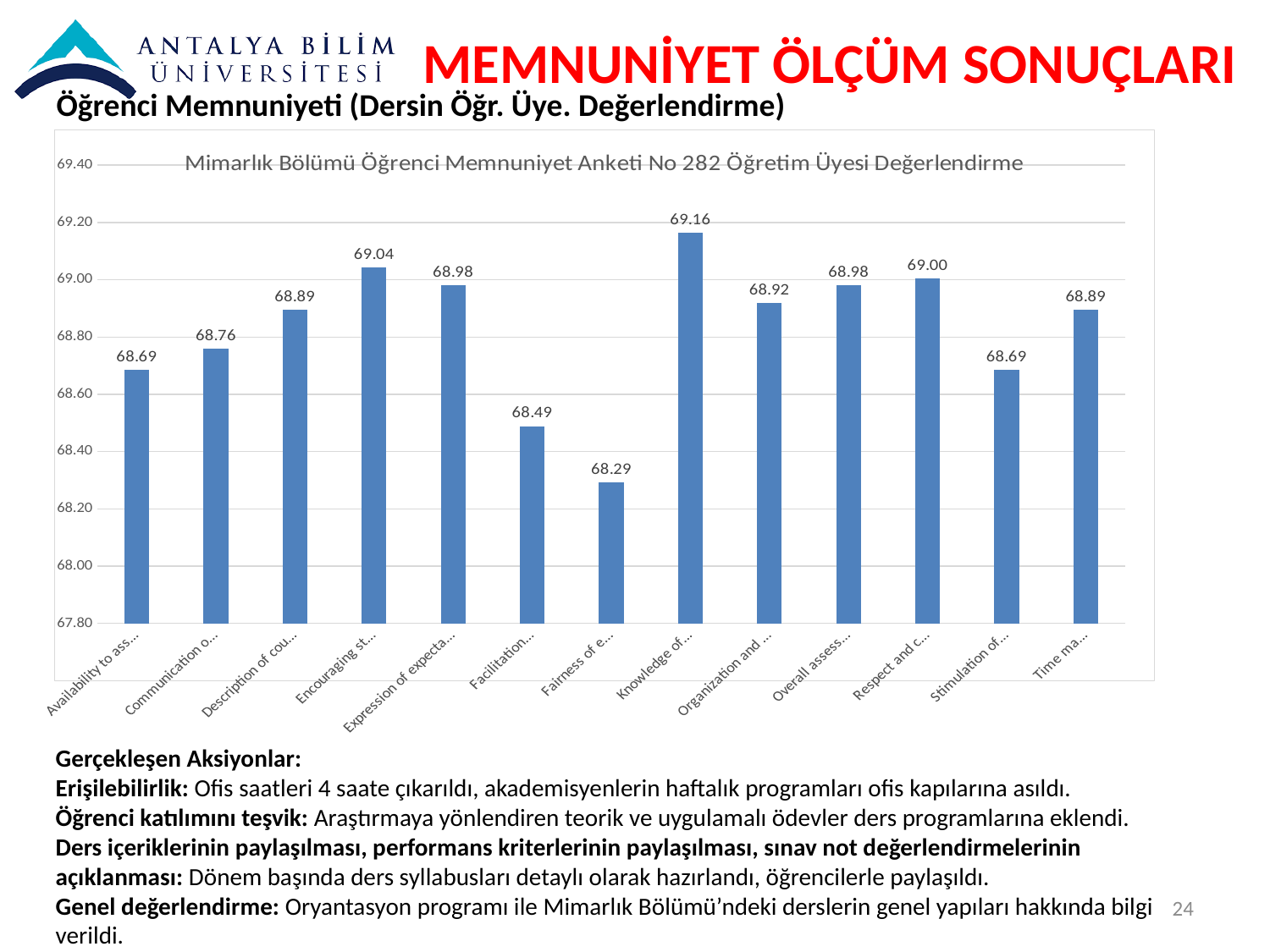
How many categories (bars) are plotted in the chart? 13 What is the value of the bar for the category beginning 'Encouraging st'? 69.04 What is the value of the bar for the category beginning 'Facilitation'? 68.49 What is the difference between the highest bar (Knowledge of...) and the lowest bar (Fairness of e...)? 0.87 Which category has the lowest value in the chart? Fairness of e... What is the value of the bar for the category beginning 'Fairness of e'? 68.29 Which category has the highest value in the chart? Knowledge of... Which is larger: the value for the category beginning 'Respect and c' or the category beginning 'Organization and'? Respect and c... Is the value for the category beginning 'Communication o' greater or less than 68.80? less What is the title of the chart? Mimarlık Bölümü Öğrenci Memnuniyet Anketi No 282 Öğretim Üyesi Değerlendirme What type of chart is shown on the slide? bar chart What is the value of the bar for the category beginning 'Knowledge of'? 69.16